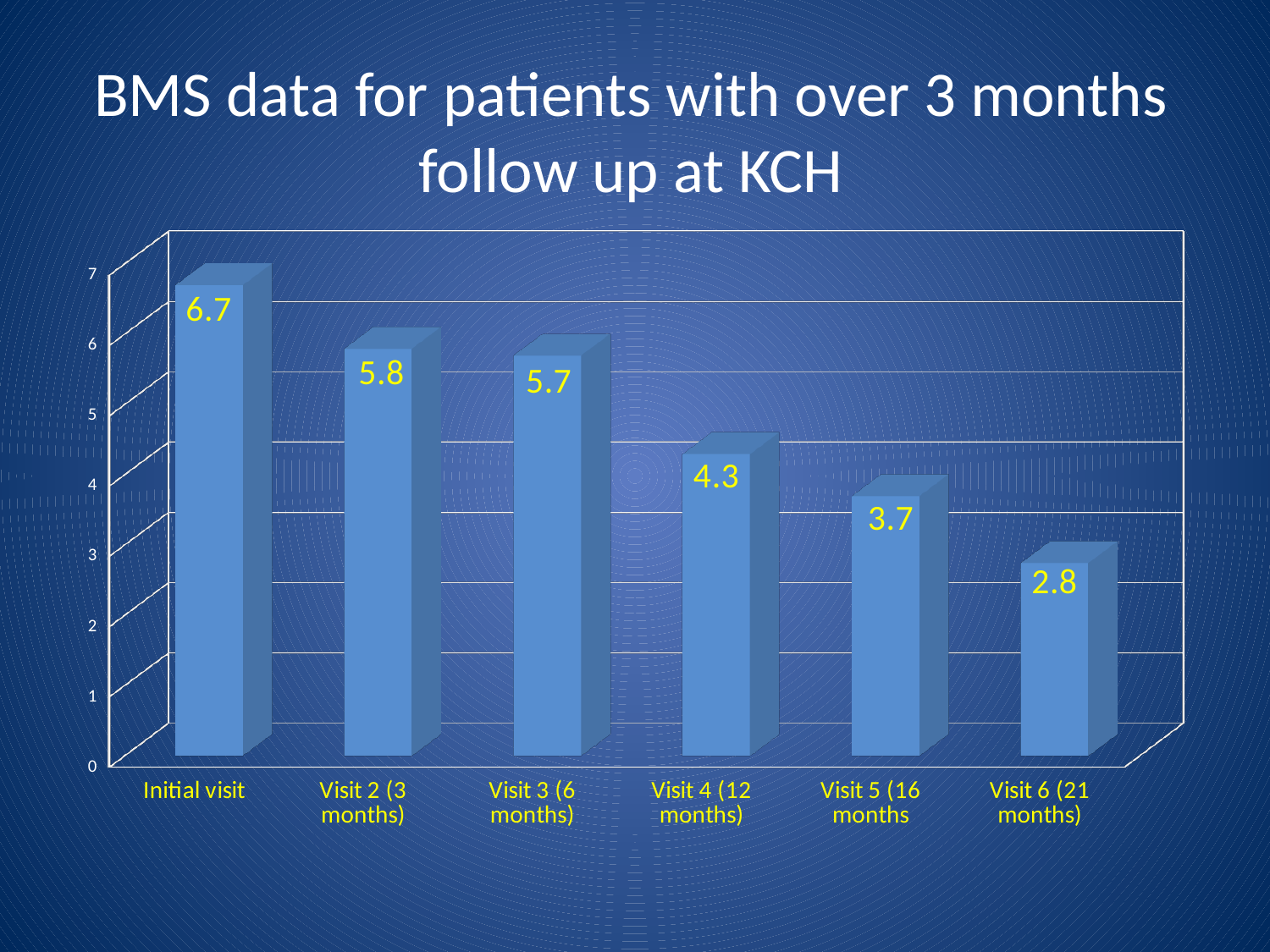
Which is larger, the value for Visit 4 (12 months) or the value for Visit 5 (16 months)? Visit 4 (12 months) What kind of chart is shown on the slide? Bar chart What is the value for Visit 4 (12 months)? 4.3 Is the value for Visit 5 (16 months) greater or less than 4? less What is the value for the Initial visit? 6.7 Which visit has the lowest value? Visit 6 (21 months) What is the difference between the Visit 2 (3 months) value and the Visit 3 (6 months) value? 0.1 What is the value for Visit 6 (21 months)? 2.8 Which visit has the highest value? Initial visit Do the values rise or fall from the Initial visit to Visit 6 (21 months)? Fall How many visits are shown on the chart? 6 What is the difference between the Initial visit value and the Visit 6 (21 months) value? 3.9